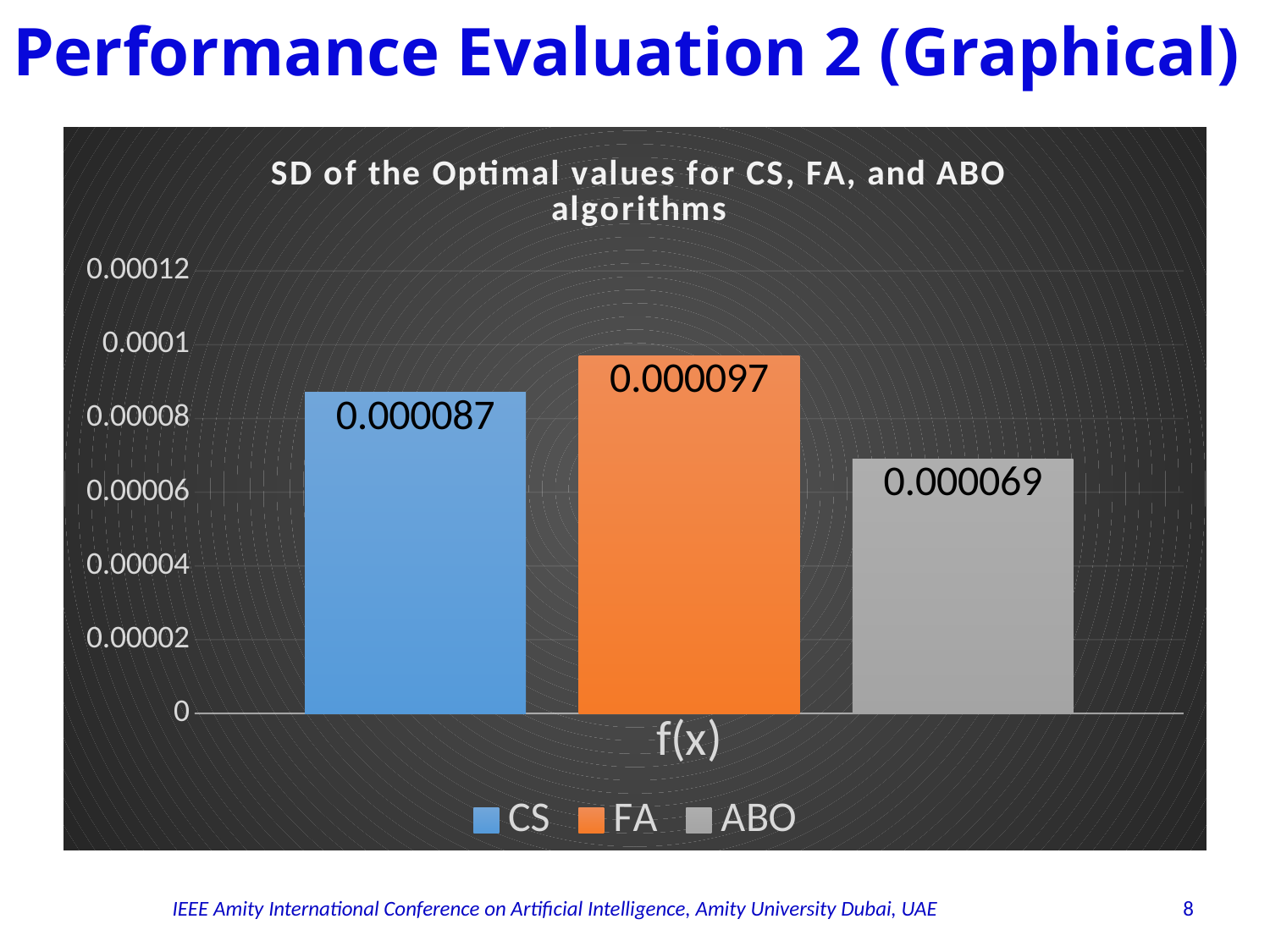
What is the SD value for the ABO algorithm? 0.000069 What is the difference between the SD values for CS and ABO? 0.000018 Which algorithm has the highest SD of the optimal values? FA Which algorithm has the lowest SD of the optimal values? ABO What is the title of the chart? SD of the Optimal values for CS, FA, and ABO algorithms What is the difference between the SD values for FA and CS? 0.00001 How many series does the legend list? 3 What is the SD value for the FA algorithm? 0.000097 Which has a larger SD value, CS or ABO? CS What kind of chart is shown on the slide? bar chart Is the SD value for ABO greater or less than 0.00008? less What is the SD value for the CS algorithm? 0.000087